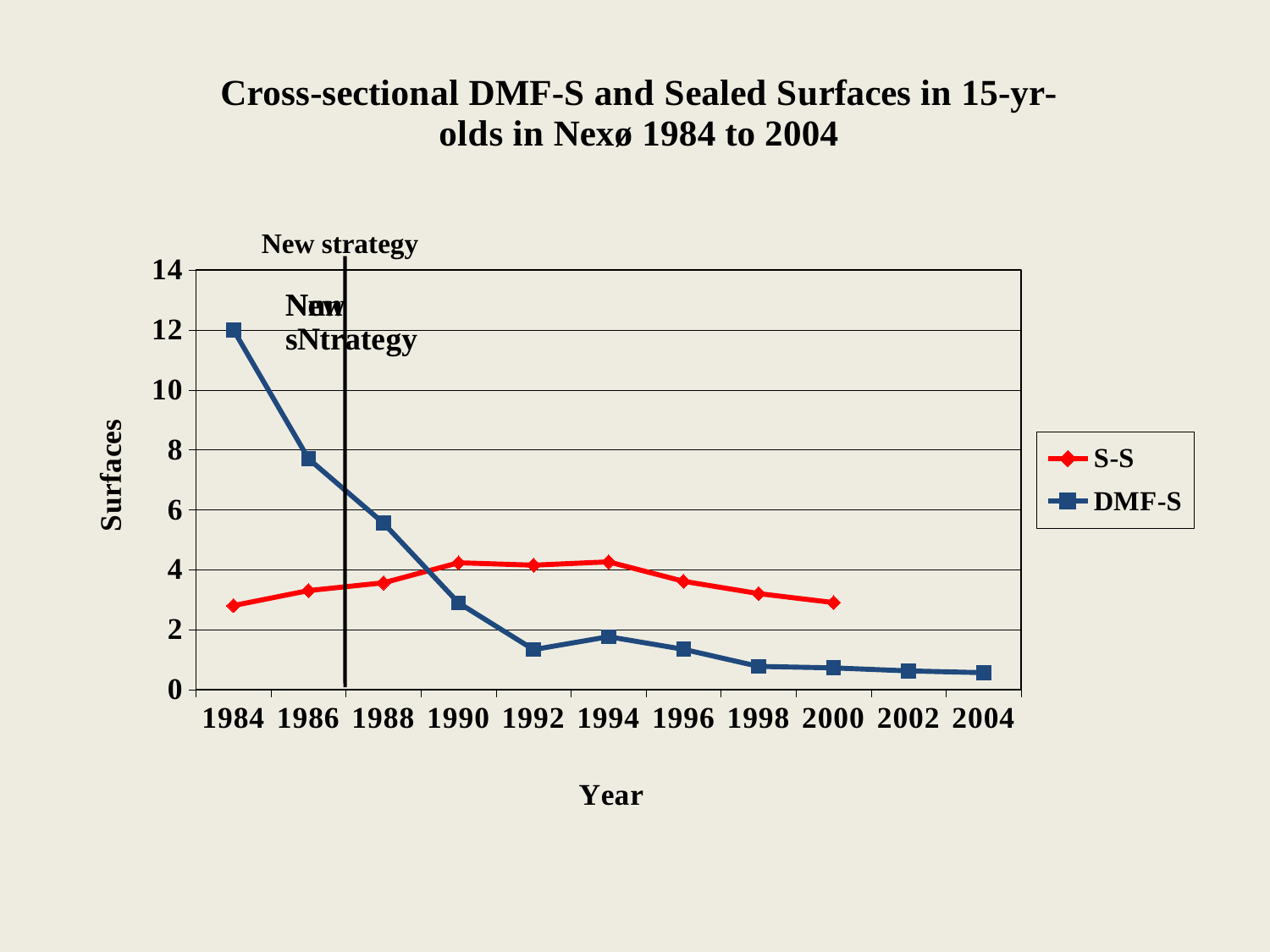
What does the vertical line drawn on the chart mark? New strategy How many years are labelled on the x axis? 11 In which year is the DMF-S value highest? 1984 Is the DMF-S value for 1986 greater or less than 6? greater How many series does the legend list? 2 Does the DMF-S series rise or fall from 1984 to 2004? fall In 1996, which series has the larger value, S-S or DMF-S? S-S What kind of chart is shown on the slide? line chart Is the DMF-S value for 1992 greater or less than 2? less What is the DMF-S value in 1984? 12 Is the S-S value for 1984 greater or less than 4? less